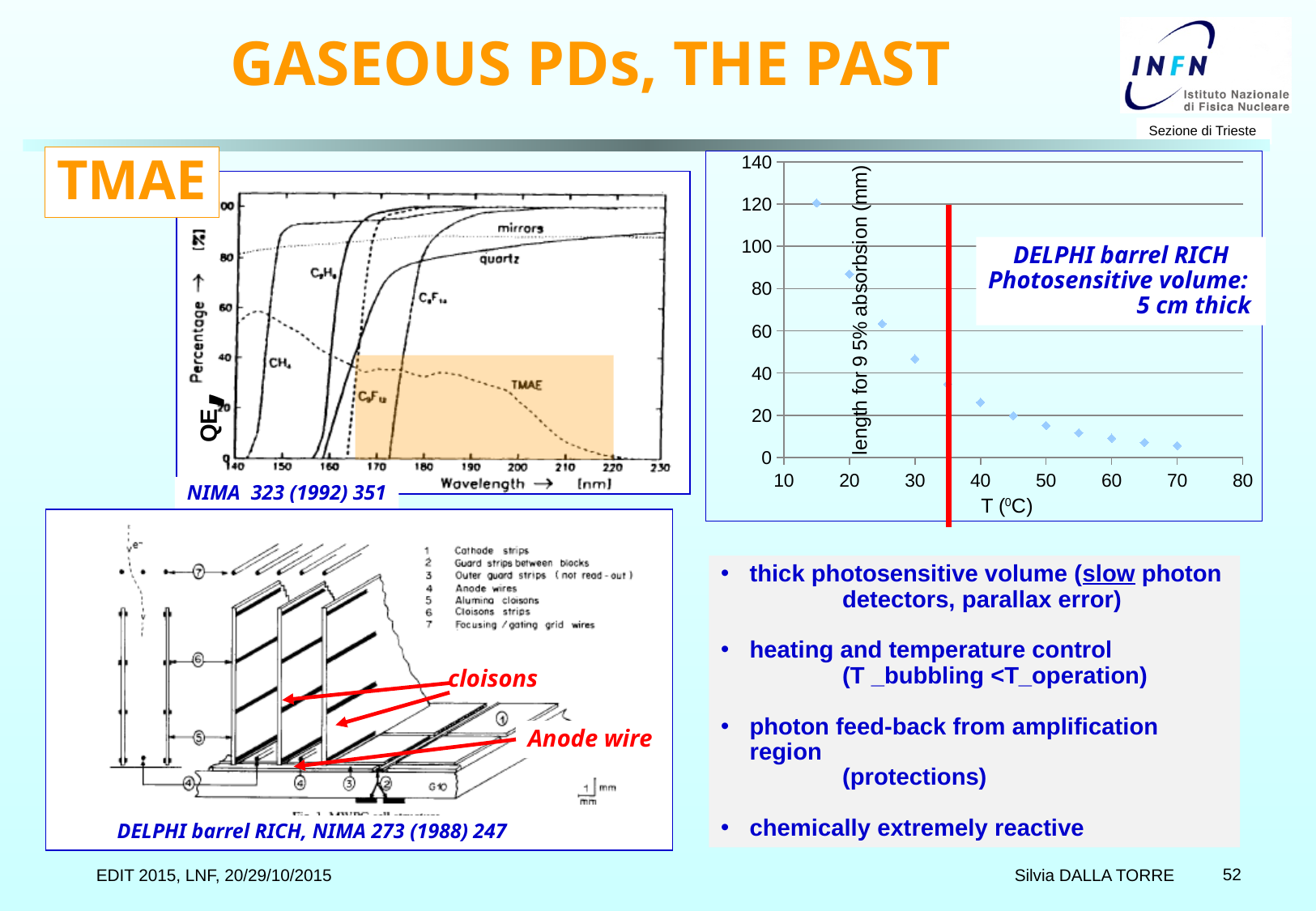
In the chart on the right, is the value at T = 40 °C greater or less than 40? less In the chart on the right, at which temperature is the plotted value highest? 15 °C In the chart on the right, how do the values change as T increases along the x axis? they fall In the chart on the right, is the value at T = 30 °C greater or less than 60? less In the chart on the right, at what temperature is the red vertical line drawn? 35 °C In the chart on the right, which has the larger value: T = 20 °C or T = 40 °C? T = 20 °C In the chart on the right, at which temperature is the plotted value lowest? 70 °C In the chart on the right, is the value at T = 70 °C greater or less than 20? less In the chart on the right (length for 95% absorption vs T), what kind of chart is it? scatter chart In the chart on the right, how many data points are plotted? 12 In the chart on the right, what is the label of the y axis? length for 95% absorbsion (mm)